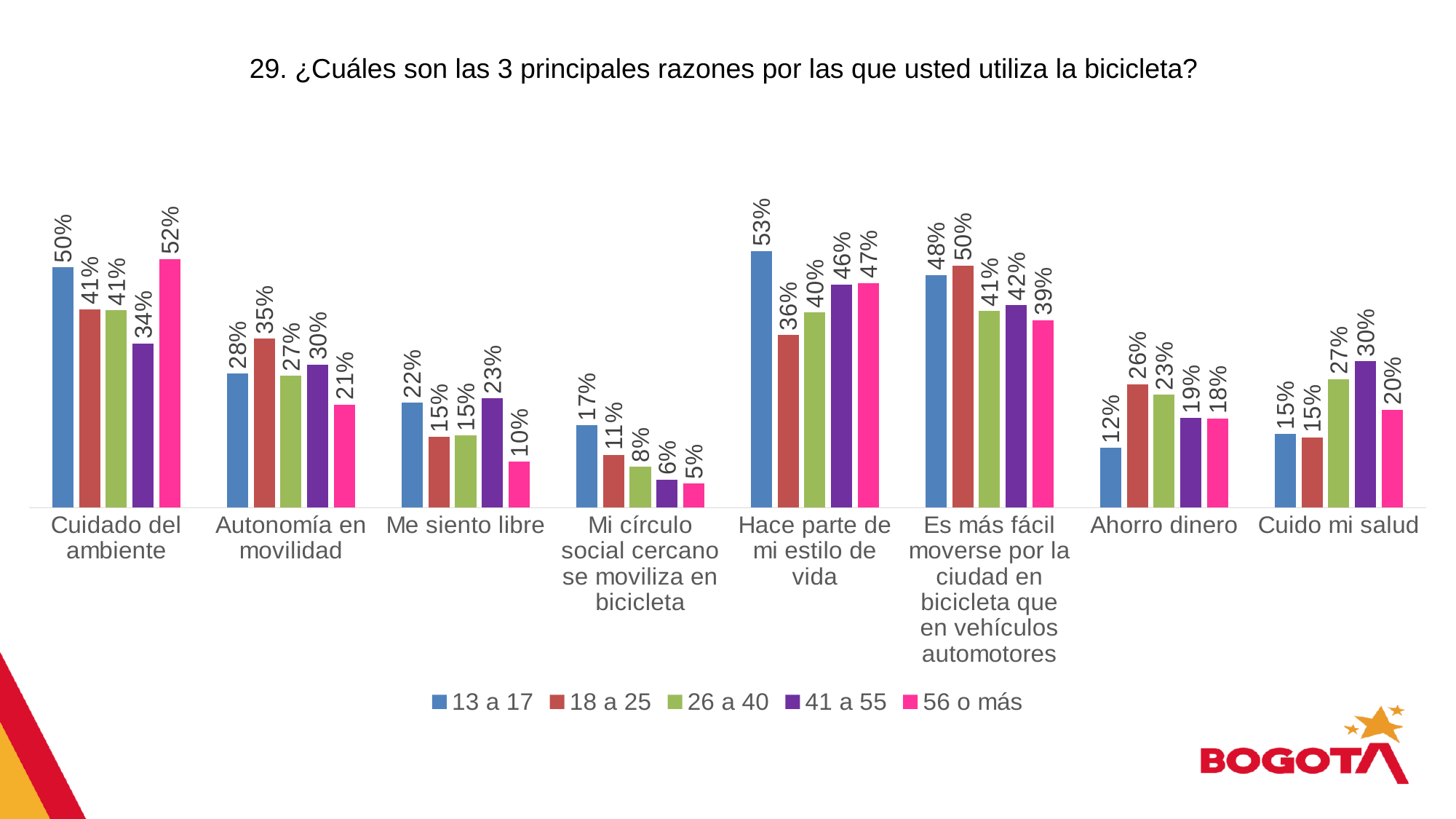
What is the value for the 18 a 25 series in the Ahorro dinero category? 26% What is the difference between the 13 a 17 and 18 a 25 values in the Hace parte de mi estilo de vida category? 17% What is the value for the 13 a 17 series in the Hace parte de mi estilo de vida category? 53% In the Me siento libre category, which is larger: the value for 13 a 17 or the value for 56 o más? 13 a 17 What is the value for the 56 o más series in the Cuidado del ambiente category? 52% What is the value for the 41 a 55 series in the Cuido mi salud category? 30% How many categories are shown on the x axis? 8 Within the Autonomía en movilidad category, which age group has the highest value? 18 a 25 Which colour represents the 56 o más series in the legend? Pink Within the Mi círculo social cercano se moviliza en bicicleta category, which age group has the lowest value? 56 o más How many series does the legend list? 5 What kind of chart is shown on the slide? Bar chart